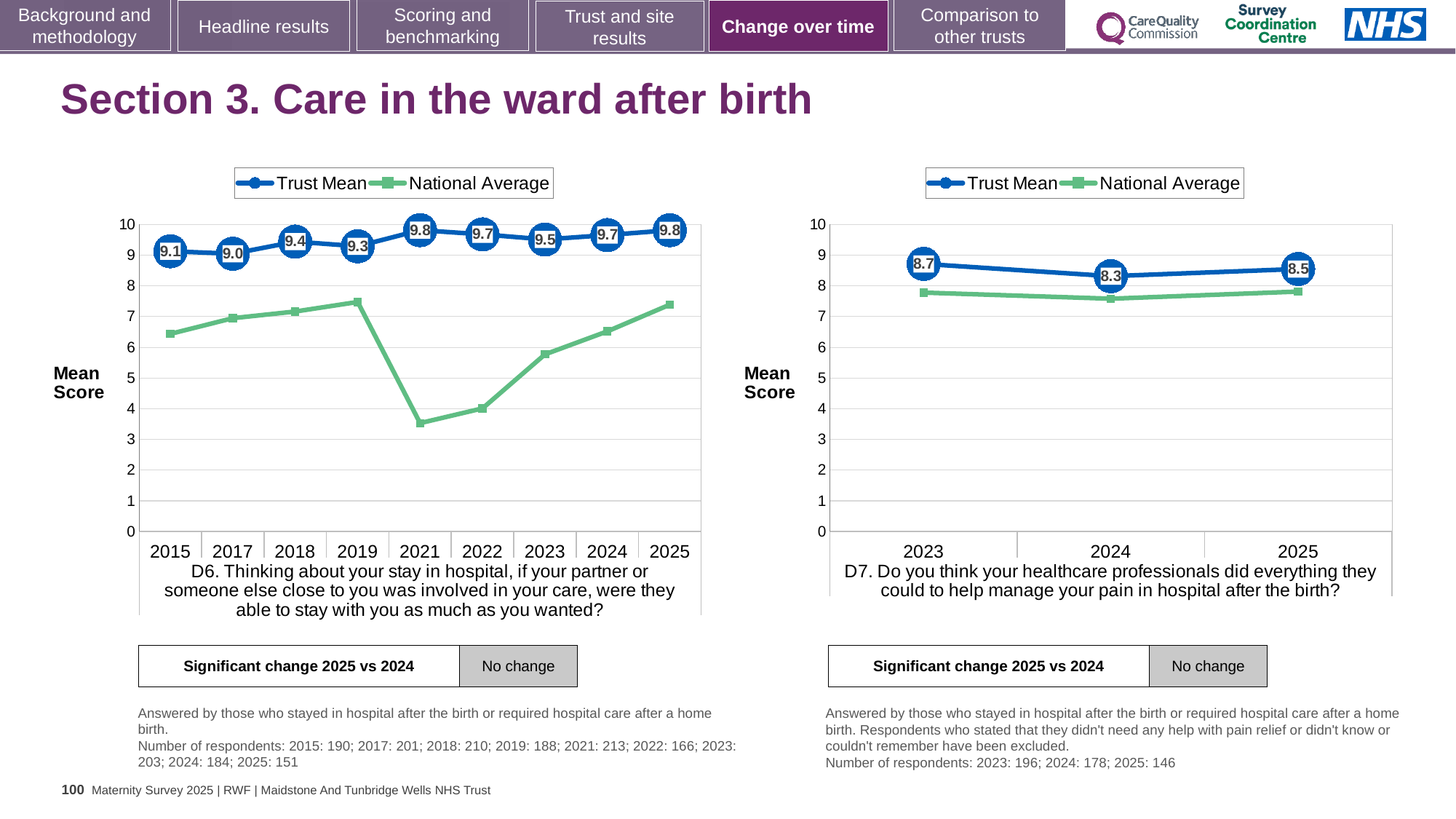
In the D7 chart on the right, is the National Average value for 2025 greater or less than 7? greater In the D6 chart on the left, which is larger: the Trust Mean for 2018 or for 2019? 2018 In the D7 chart on the right, what is the difference between the Trust Mean scores for 2023 and 2024? 0.4 What kind of chart is the D7 chart on the right? Line chart In the D6 chart on the left, what is the Trust Mean score for 2022? 9.7 In the D6 chart on the left, which year has the lowest Trust Mean score? 2017 In the D7 chart on the right, what is the Trust Mean score for 2024? 8.3 In the D6 chart on the left, what is the Trust Mean score for 2015? 9.1 In the D6 chart on the left, is the National Average value for 2021 greater or less than 4? less In the D7 chart on the right, which year has the highest Trust Mean score? 2023 How many years are shown on the x axis of the D6 chart on the left? 9 How many series does the legend of the D7 chart on the right list? 2